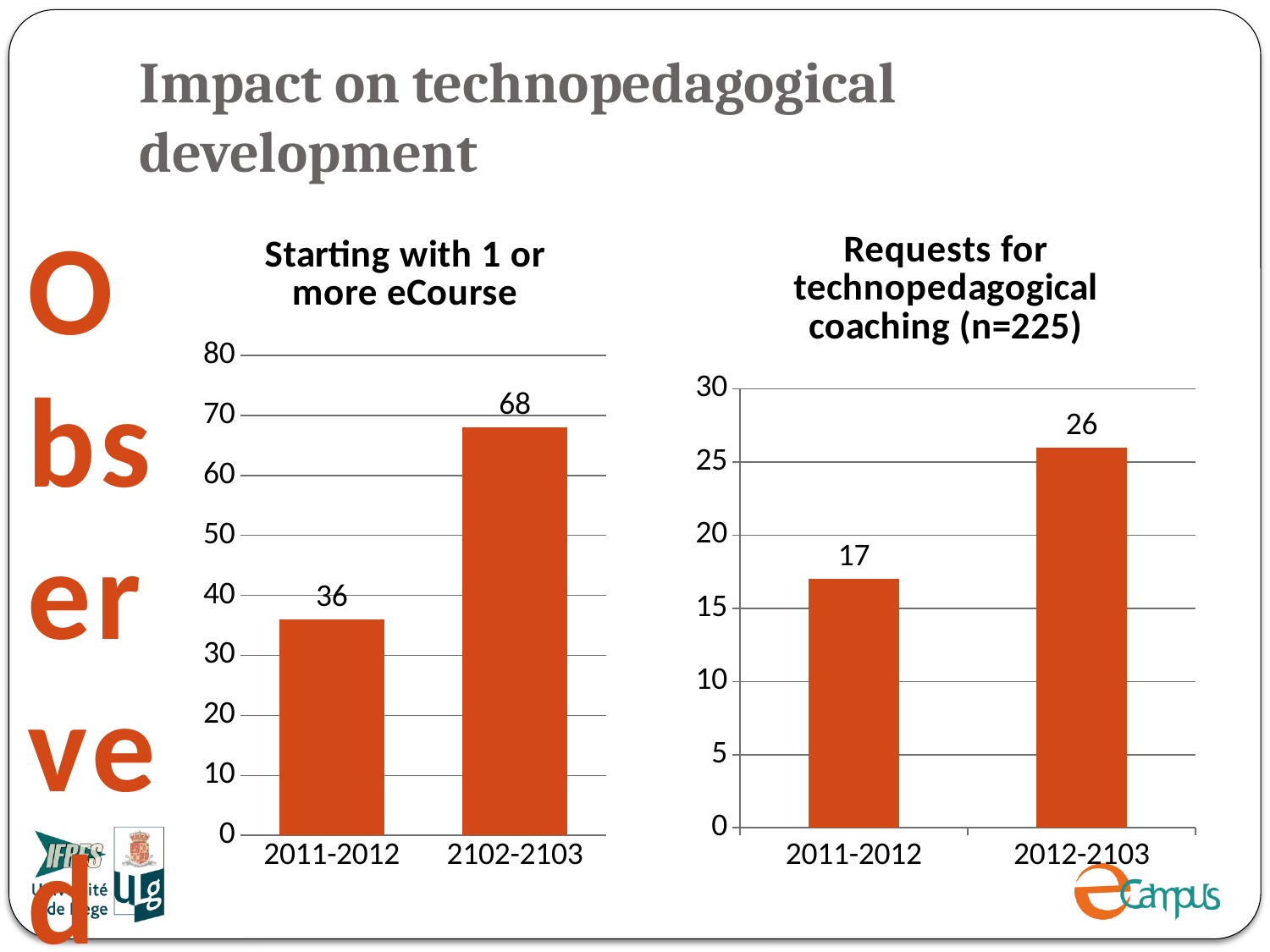
In the 'Starting with 1 or more eCourse' chart, what is the value for 2102-2103? 68 How many categories are shown in the 'Starting with 1 or more eCourse' chart? 2 In the 'Requests for technopedagogical coaching (n=225)' chart, what is the value for 2011-2012? 17 In the 'Requests for technopedagogical coaching (n=225)' chart, what is the value for 2012-2103? 26 What kind of chart is the 'Requests for technopedagogical coaching (n=225)' chart? bar chart In the 'Requests for technopedagogical coaching (n=225)' chart, is the value for 2011-2012 greater or less than 20? less In the 'Requests for technopedagogical coaching (n=225)' chart, what is the difference between the values for 2012-2103 and 2011-2012? 9 In the 'Starting with 1 or more eCourse' chart, what is the value for 2011-2012? 36 In the 'Starting with 1 or more eCourse' chart, what is the difference between the values for 2102-2103 and 2011-2012? 32 In the 'Starting with 1 or more eCourse' chart, do the values rise or fall from 2011-2012 to 2102-2103? rise In the 'Requests for technopedagogical coaching (n=225)' chart, which category has the lowest value? 2011-2012 In the 'Starting with 1 or more eCourse' chart, which category has the highest value? 2102-2103